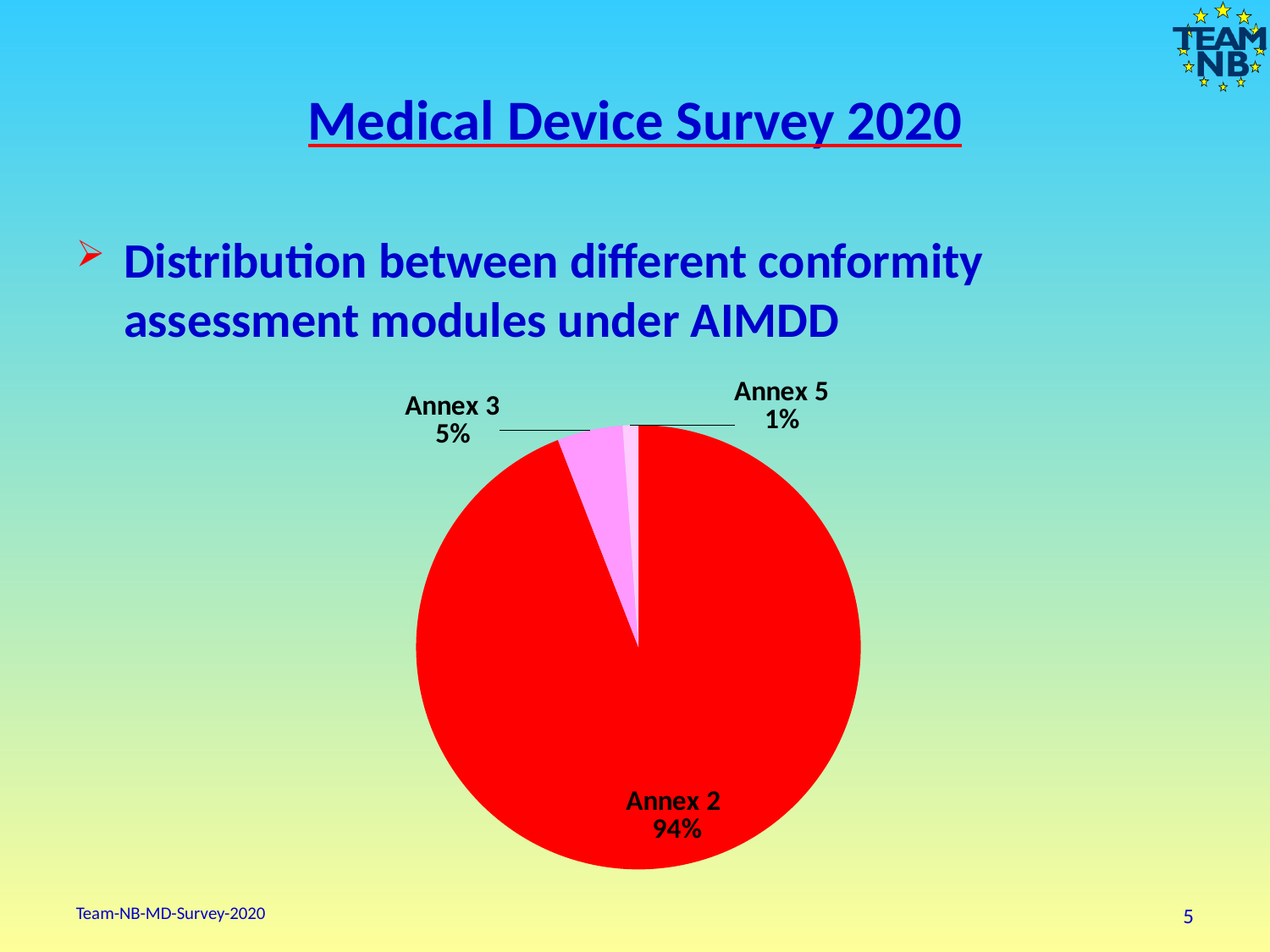
How many slices does the pie chart have? 3 Which annex has the smallest share of the pie? Annex 5 What does the pie chart show the distribution of, according to the slide text? Different conformity assessment modules under AIMDD What share of the pie does Annex 5 represent? 1% Which annex has the largest share of the pie? Annex 2 What is the difference in percentage points between the shares of Annex 3 and Annex 5? 4 Which has a larger share, Annex 3 or Annex 5? Annex 3 What share of the pie does Annex 3 represent? 5% What kind of chart is shown on the slide? Pie chart What share of the pie does Annex 2 represent? 94% What is the difference in percentage points between the shares of Annex 2 and Annex 3? 89 What colour is the Annex 2 slice of the pie? Red